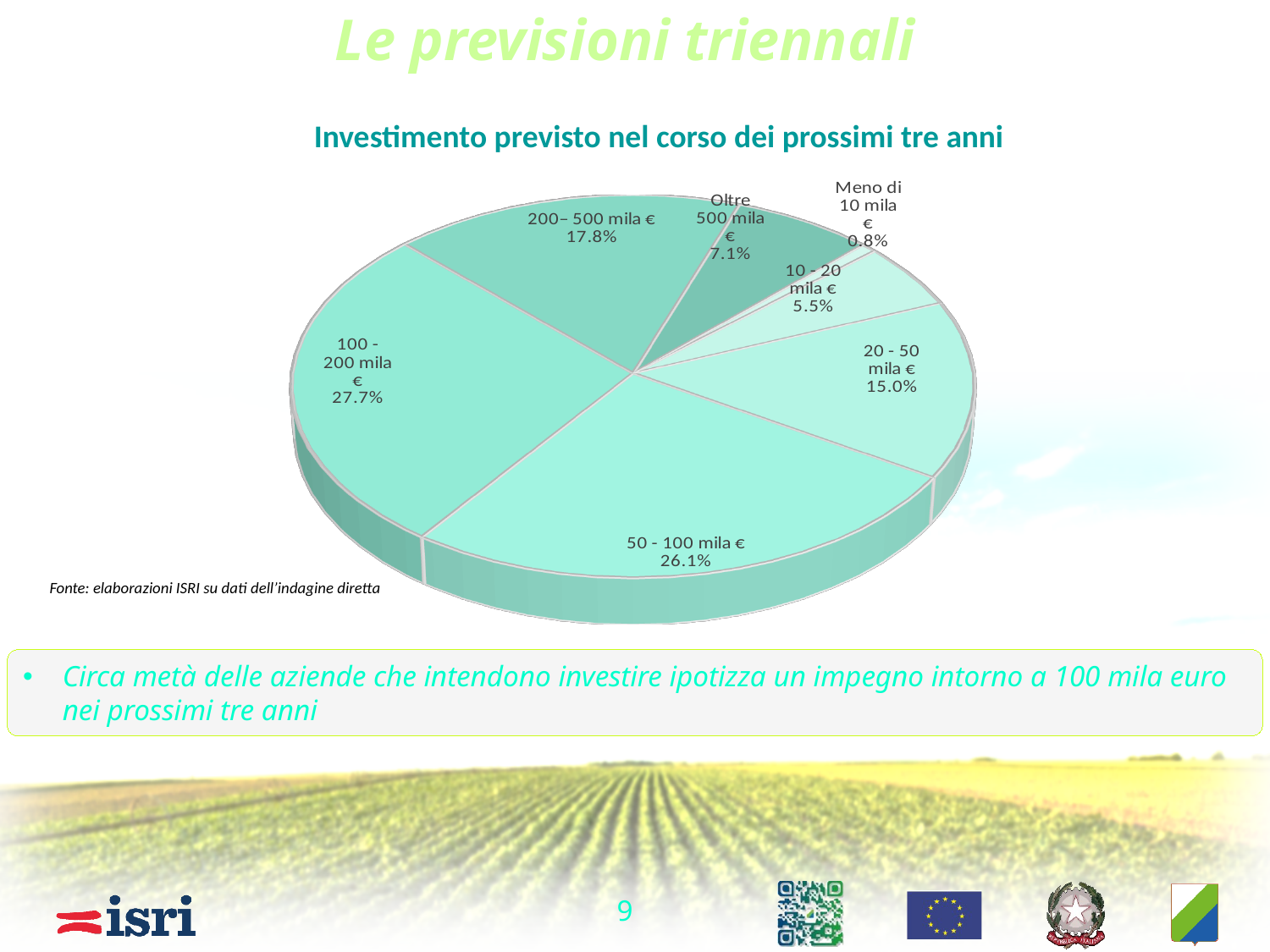
What is the title of the chart? Investimento previsto nel corso dei prossimi tre anni What is the difference between the '200– 500 mila €' share and the '10 - 20 mila €' share? 12.3% Which is larger: the share for '50 - 100 mila €' or the share for '200– 500 mila €'? 50 - 100 mila € What is the value shown for the '50 - 100 mila €' slice? 26.1% Which category has the smallest share of the pie? Meno di 10 mila € Which category has the largest share of the pie? 100 - 200 mila € What is the combined share of the '50 - 100 mila €' and '100 - 200 mila €' slices? 53.8% How many slices does the pie chart have? 7 What is the value for the '20 - 50 mila €' category? 15.0% What type of chart is shown on the slide? Pie chart What percentage is shown for the 'Oltre 500 mila €' slice? 7.1% What share of the pie does the '100 - 200 mila €' slice represent? 27.7%